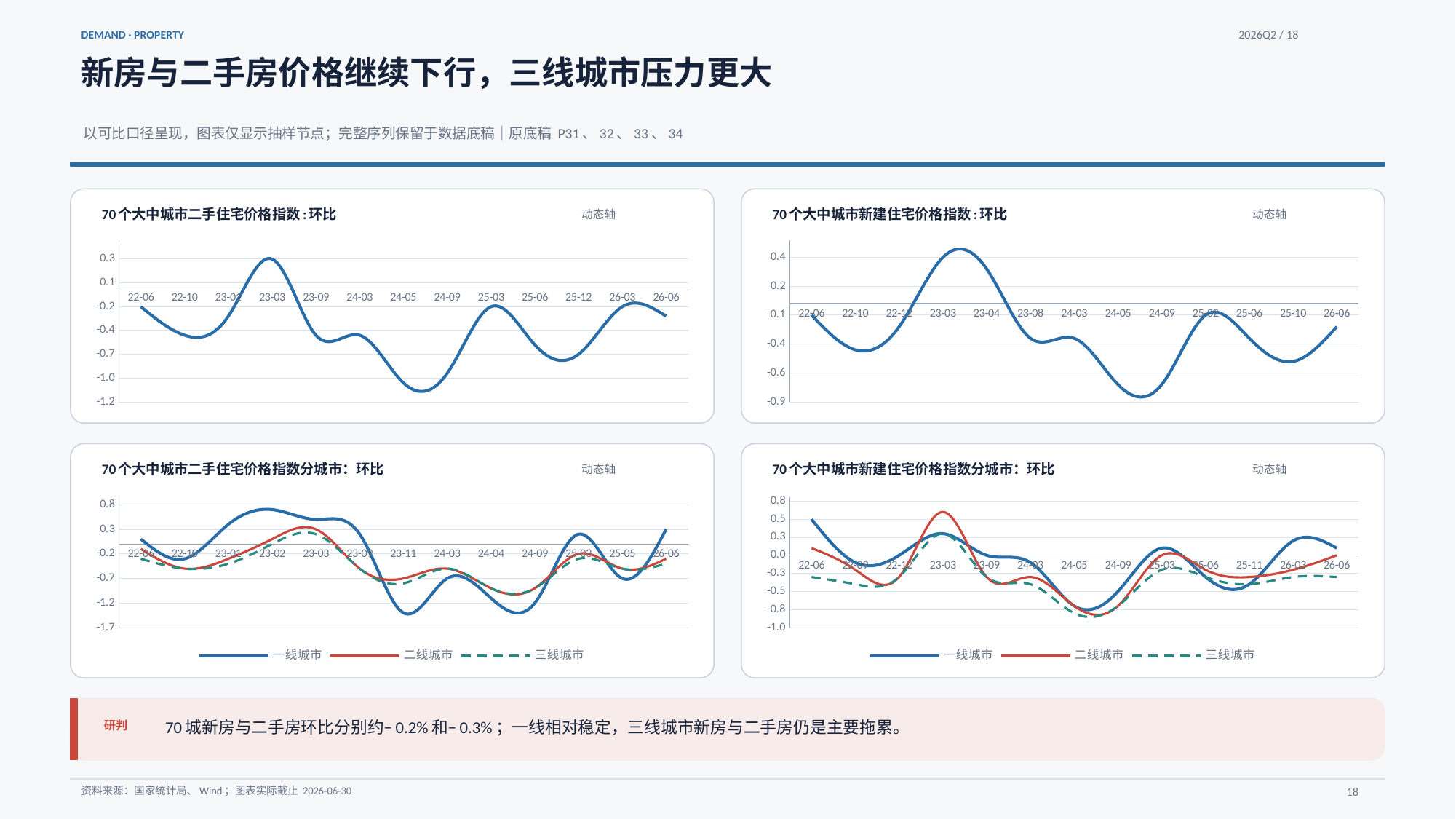
In the top-left chart '70个大中城市二手住宅价格指数:环比', at which date is the value lowest? 24-05 In the bottom-left chart '70个大中城市二手住宅价格指数分城市：环比', which series has the highest value at 23-02? 一线城市 In the bottom-right chart '70个大中城市新建住宅价格指数分城市：环比', which series has the highest value at 23-03? 二线城市 In the top-right chart '70个大中城市新建住宅价格指数:环比', is the value for 23-03 greater or less than 0.2? greater In the top-right chart '70个大中城市新建住宅价格指数:环比', at which date is the value highest? 23-03 What kind of chart is the top-left chart titled '70个大中城市二手住宅价格指数:环比'? line chart In the top-left chart '70个大中城市二手住宅价格指数:环比', how many dates are shown on the x axis? 13 How many series does the legend of the bottom-left chart '70个大中城市二手住宅价格指数分城市：环比' list? 3 In the top-left chart '70个大中城市二手住宅价格指数:环比', at which date is the value highest? 23-03 What are the legend entries of the bottom-right chart '70个大中城市新建住宅价格指数分城市：环比'? 一线城市, 二线城市, 三线城市